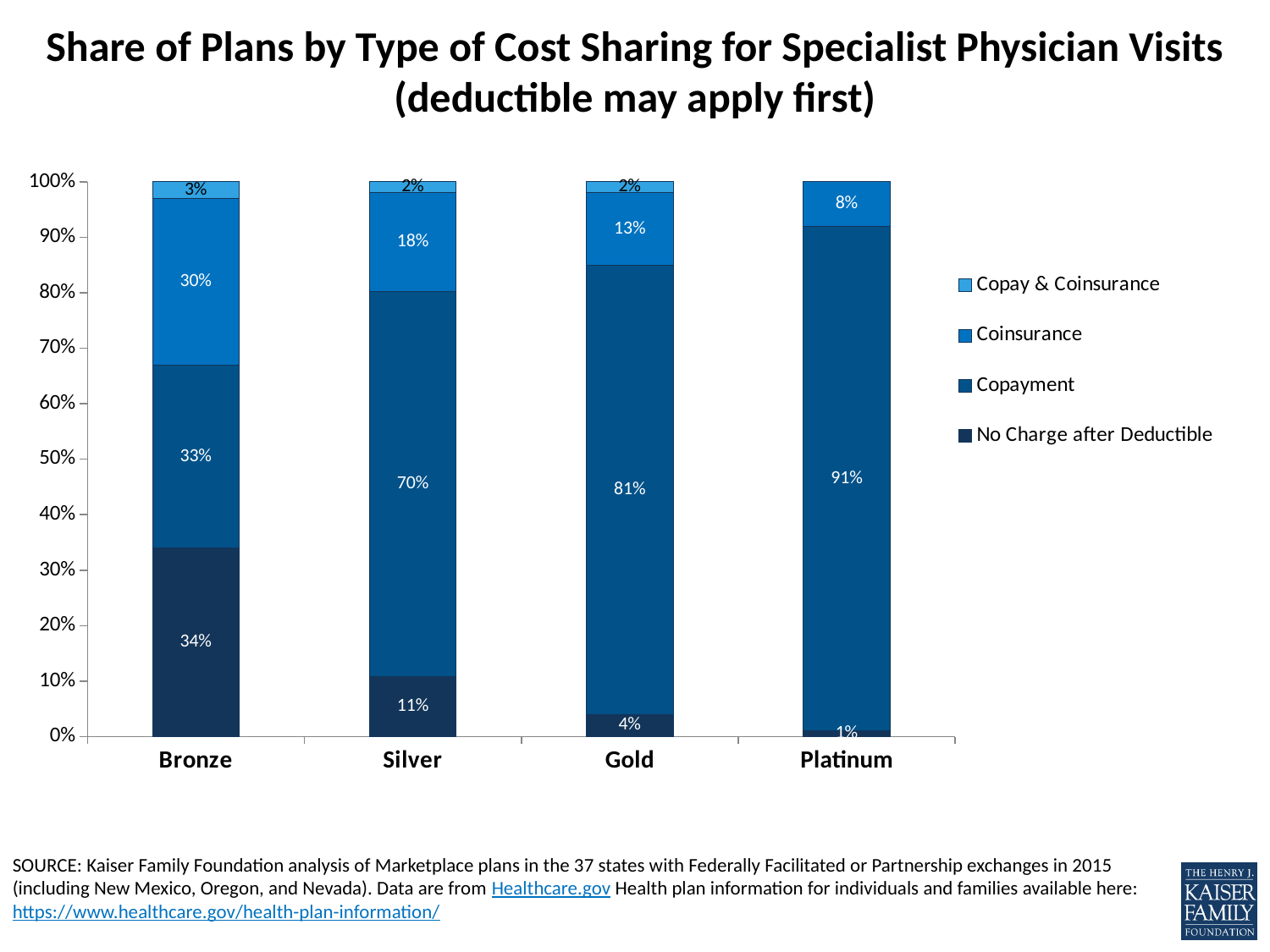
Which plan type has the lowest No Charge after Deductible share? Platinum What is the difference between the Copayment share for Gold and for Silver? 11 percentage points How many series does the legend list? 4 What is the Coinsurance share for Gold plans? 13% Which has a larger Coinsurance share, Bronze or Silver? Bronze What kind of chart is shown on the slide? Stacked bar chart Does the Copayment share rise or fall from Bronze to Platinum? Rises What is the Copayment share for Silver plans? 70% How many plan types are shown on the x axis? 4 Which plan type has the highest Copayment share? Platinum What is the Copay & Coinsurance share for Bronze plans? 3% What is the No Charge after Deductible share for Bronze plans? 34%